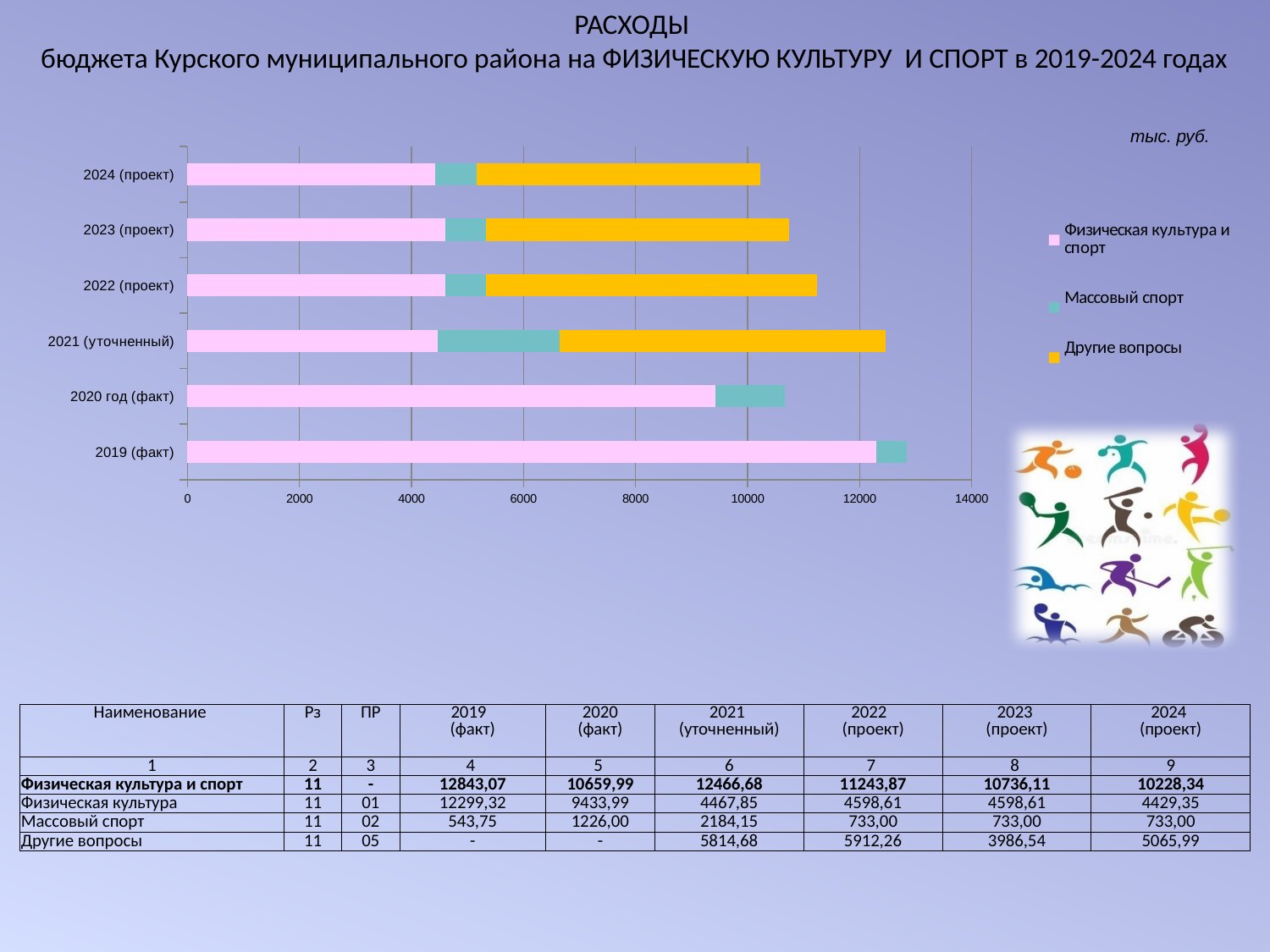
Is the Массовый спорт segment larger for 2021 (уточненный) or for 2020 год (факт)? 2021 (уточненный) Which series is shown in yellow in the chart? Другие вопросы In what units are the chart values given? тыс. руб. What kind of chart is shown on the slide? bar chart Is the total length of the bar for 2019 (факт) greater or less than 12000? greater Which year has the longest total bar in the chart? 2019 (факт) According to the table on the slide, what is the total for Физическая культура и спорт in 2021 (уточненный)? 12466,68 Is the total length of the bar for 2020 год (факт) greater or less than 10000? greater How many year categories does the chart show? 6 According to the table on the slide, what is the difference between Массовый спорт in 2021 (уточненный) and in 2022 (проект)? 1451,15 How many series does the chart legend list? 3 Is the total length of the bar for 2022 (проект) greater or less than 12000? less